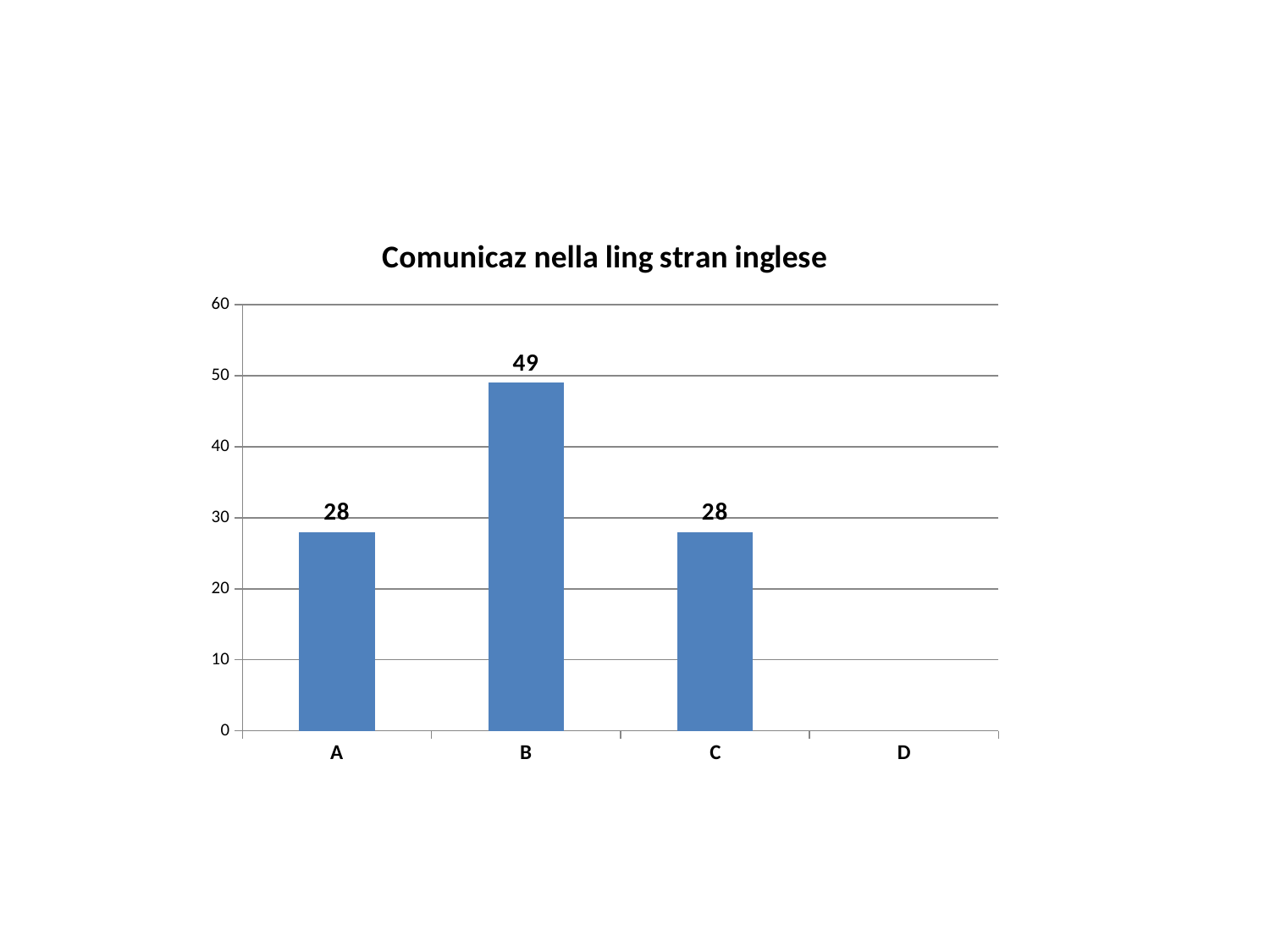
What is the title of the chart? Comunicaz nella ling stran inglese What is the difference between the values for B and A? 21 What is the value for category B? 49 What is the value for category C? 28 Is the value for A greater or less than 30? less Which category has the highest value? B What is the maximum value shown on the y axis? 60 Which is larger, the value for B or the value for C? B What is the value for category A? 28 How many categories are shown on the x axis? 4 What kind of chart is shown on the slide? bar chart Is the value for B greater or less than 40? greater